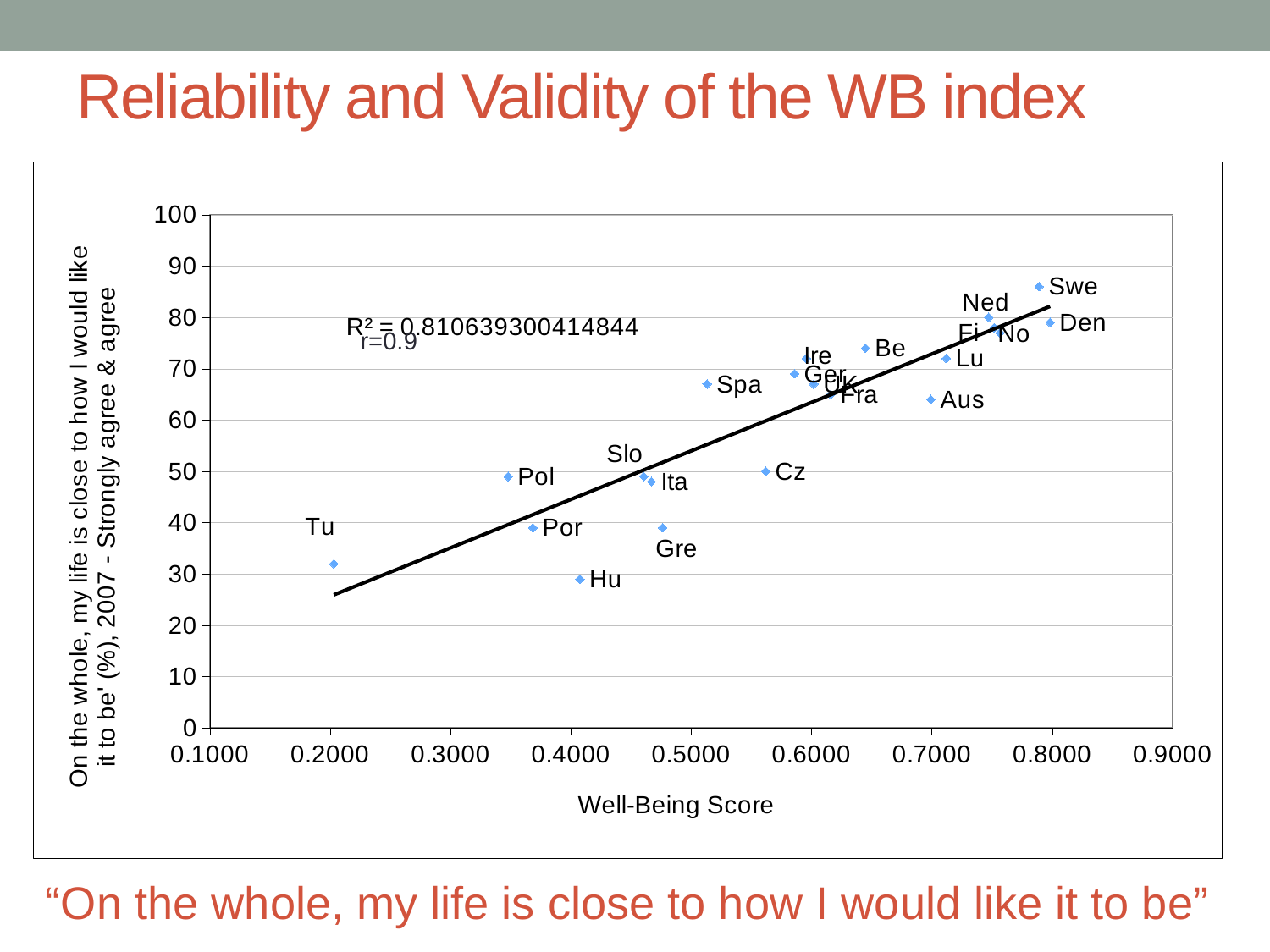
Which has the higher percentage value, Be or Aus? Be Which country has the highest value on the vertical axis (percentage agreeing)? Swe What R² value is printed on the chart? 0.810639300414844 Which country has the lowest Well-Being Score on the horizontal axis? Tu Which country has the lowest value on the vertical axis (percentage agreeing)? Hu Is the Well-Being Score for Tu greater or less than 0.3000? less What kind of chart is shown on the slide? scatter chart Is the percentage value for Aus greater or less than 70? less What is the title of the horizontal axis? Well-Being Score Is the percentage value for Tu greater or less than 40? less Which has the higher percentage value, Spa or Cz? Spa